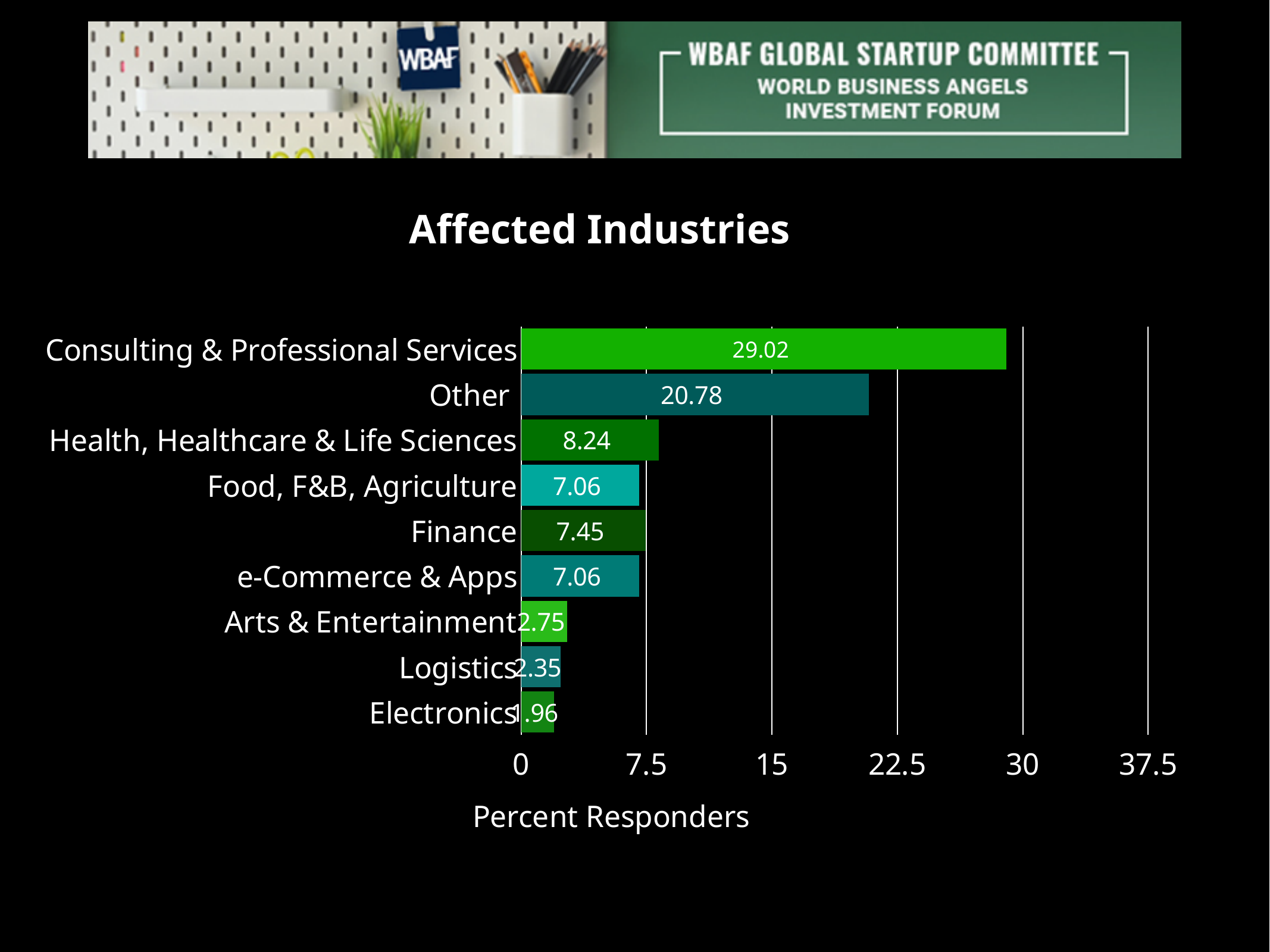
What is the difference between Finance and Food, F&B, Agriculture? 0.39 What is the value for Logistics? 2.35 What is the value for Consulting & Professional Services? 29.02 What is the value for Health, Healthcare & Life Sciences? 8.24 What is the title of the chart? Affected Industries Which industry has the lowest percent of responders? Electronics Which is larger, Other or Health, Healthcare & Life Sciences? Other How many industries are shown in the chart? 9 What is the difference between Consulting & Professional Services and Other? 8.24 What kind of chart is shown on the slide? bar chart Which industry has the highest percent of responders? Consulting & Professional Services Is the value for Other greater or less than 22.5? less